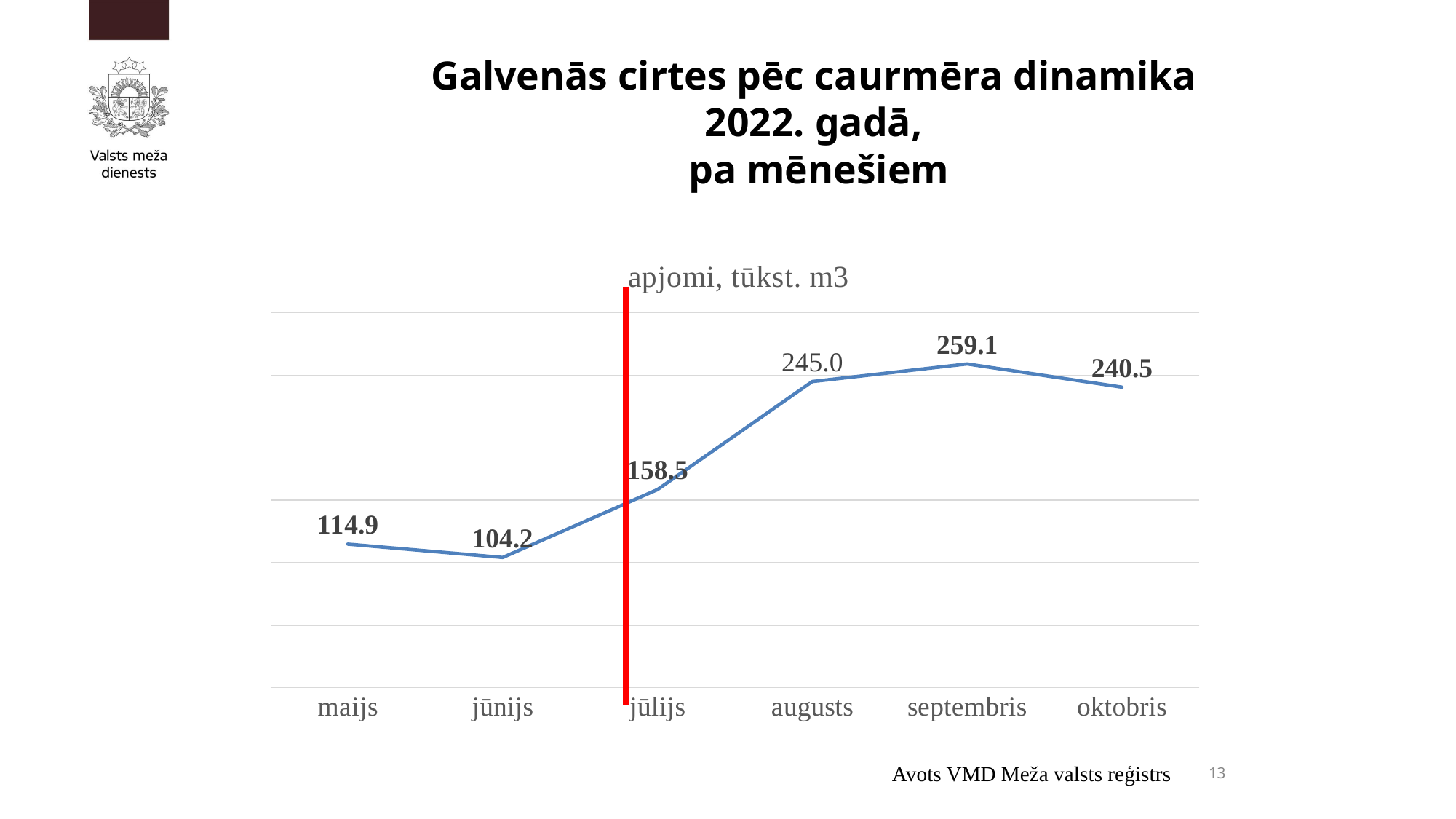
What is the title of the chart? apjomi, tūkst. m3 What is the difference between the values for septembris and oktobris? 18.6 What is the value for augusts? 245.0 What is the difference between the values for augusts and jūlijs? 86.5 How many months are plotted on the chart? 6 What is the value for maijs? 114.9 Which month has the lowest value? jūnijs Do the values rise or fall from jūnijs to septembris? rise Which is larger, the value for maijs or the value for jūnijs? maijs What kind of chart is shown on the slide? line chart What is the value for jūlijs? 158.5 Which month has the highest value? septembris